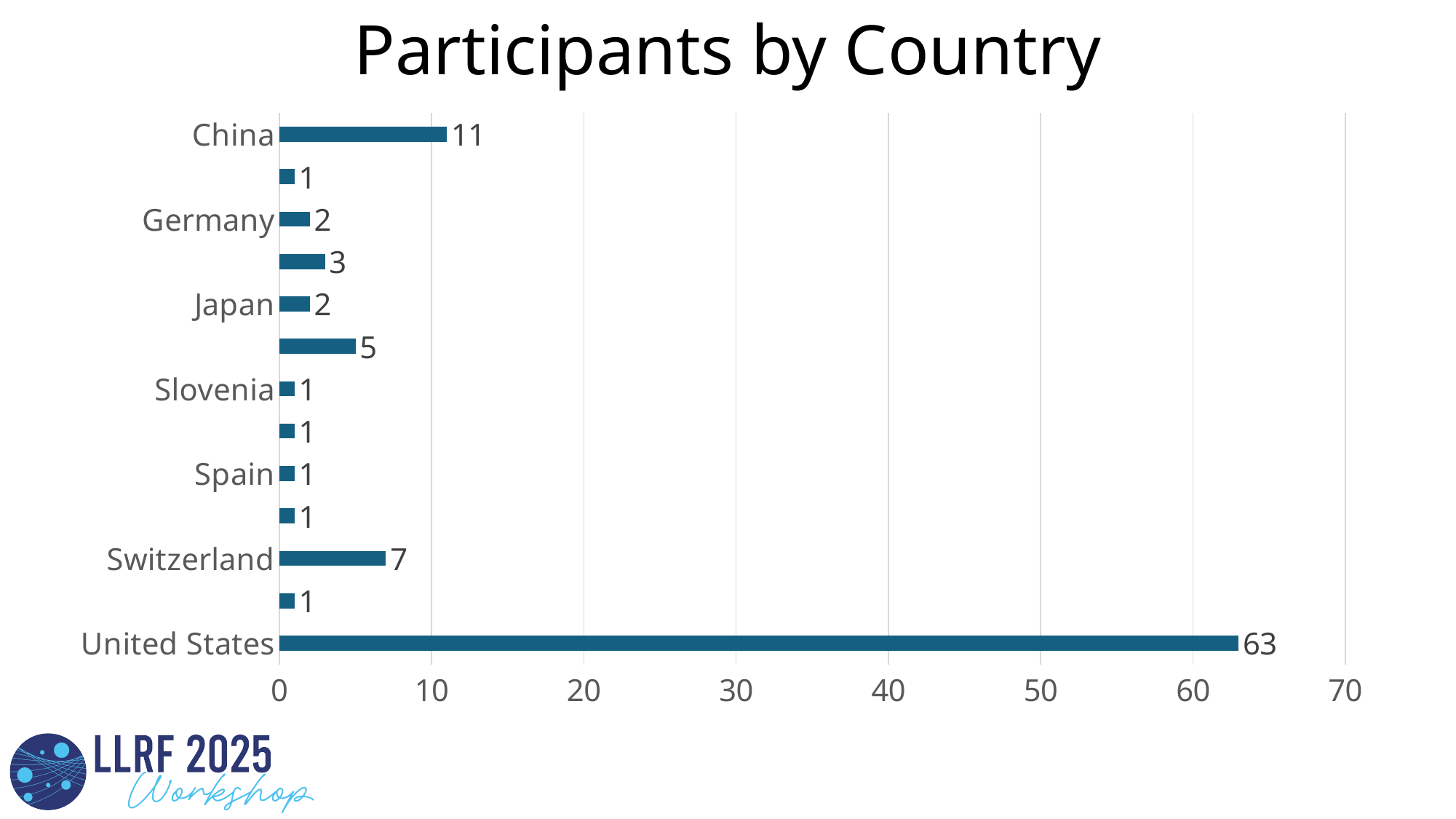
What is the difference between the values for United States and China? 52 What is the value for Switzerland? 7 What kind of chart is shown on the slide? bar chart What is the value for Slovenia? 1 Is the value for United States greater or less than 60? greater What is the value for United States? 63 What is the value for Germany? 2 What is the title of the chart? Participants by Country Which is larger, the value for China or the value for Switzerland? China What is the value for China? 11 What is the difference between the values for Switzerland and Japan? 5 Which country has the highest number of participants? United States